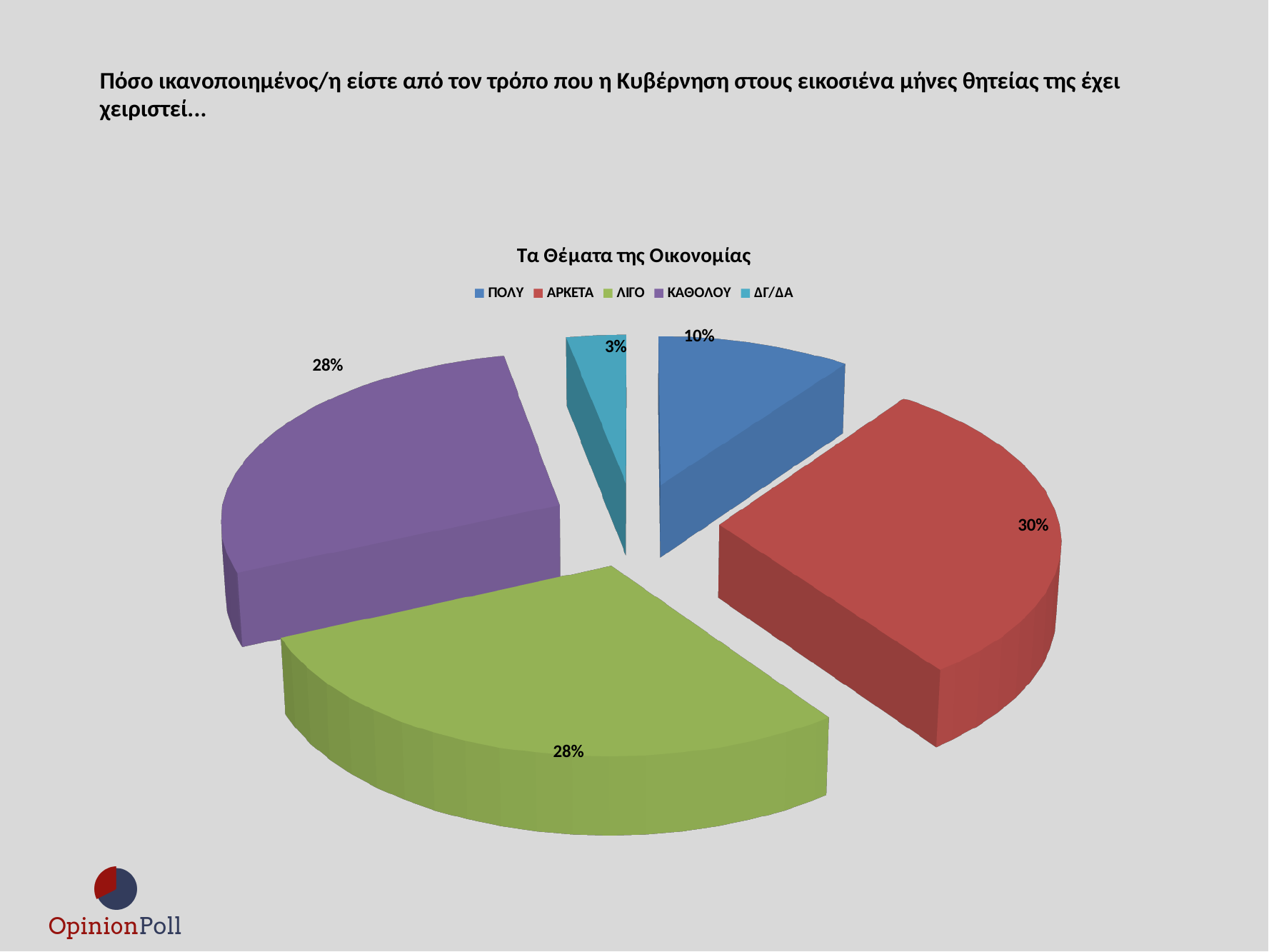
What is the difference in percentage points between ΑΡΚΕΤΑ and ΠΟΛΥ? 20 How many categories does the legend of the pie chart list? 5 What percentage of the pie is ΑΡΚΕΤΑ? 30% What percentage of the pie is ΛΙΓΟ? 28% Which colour represents ΚΑΘΟΛΟΥ in the pie chart? Purple What percentage of the pie is ΠΟΛΥ? 10% What is the title of the chart? Τα Θέματα της Οικονομίας What percentage of the pie is ΔΓ/ΔΑ? 3% Which category has the smallest share of the pie? ΔΓ/ΔΑ What percentage of the pie is ΚΑΘΟΛΟΥ? 28% What type of chart is shown on the slide? Pie chart Which category has the largest share of the pie? ΑΡΚΕΤΑ